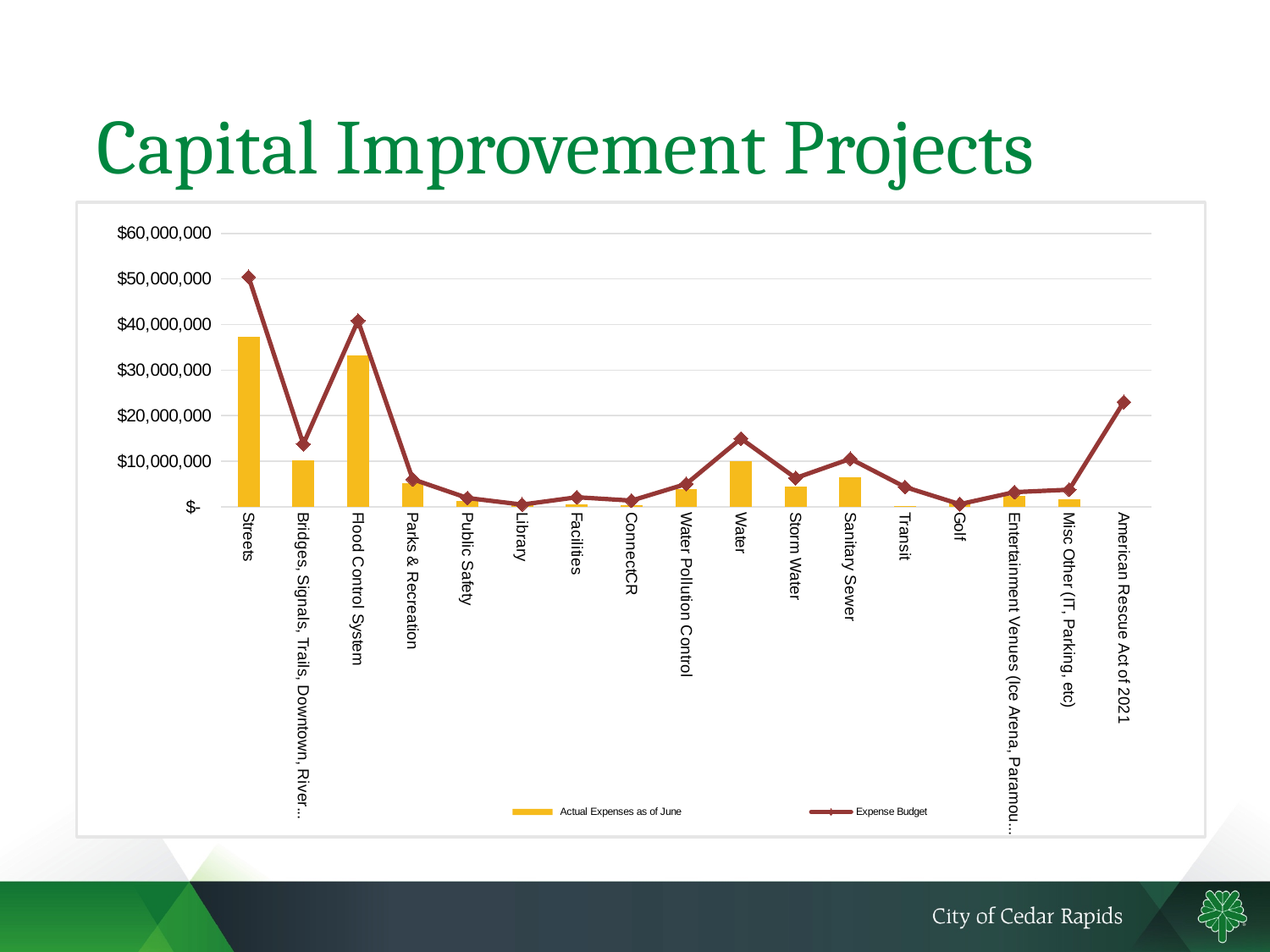
What are the two series named in the chart legend? Actual Expenses as of June; Expense Budget How many categories are shown on the x axis of the chart? 17 Is the Expense Budget value for Streets greater or less than $40,000,000? greater Which has the larger Actual Expenses as of June bar, Streets or Flood Control System? Streets Which has the larger Expense Budget value, Water or Golf? Water What kind of chart is shown on the slide? A bar chart combined with a line chart Is the Actual Expenses as of June value for Streets greater or less than $30,000,000? greater How many series does the chart legend list? 2 Is the Expense Budget value for American Rescue Act of 2021 greater or less than $20,000,000? greater Which category has the highest Expense Budget value? Streets Which category has the highest Actual Expenses as of June bar? Streets